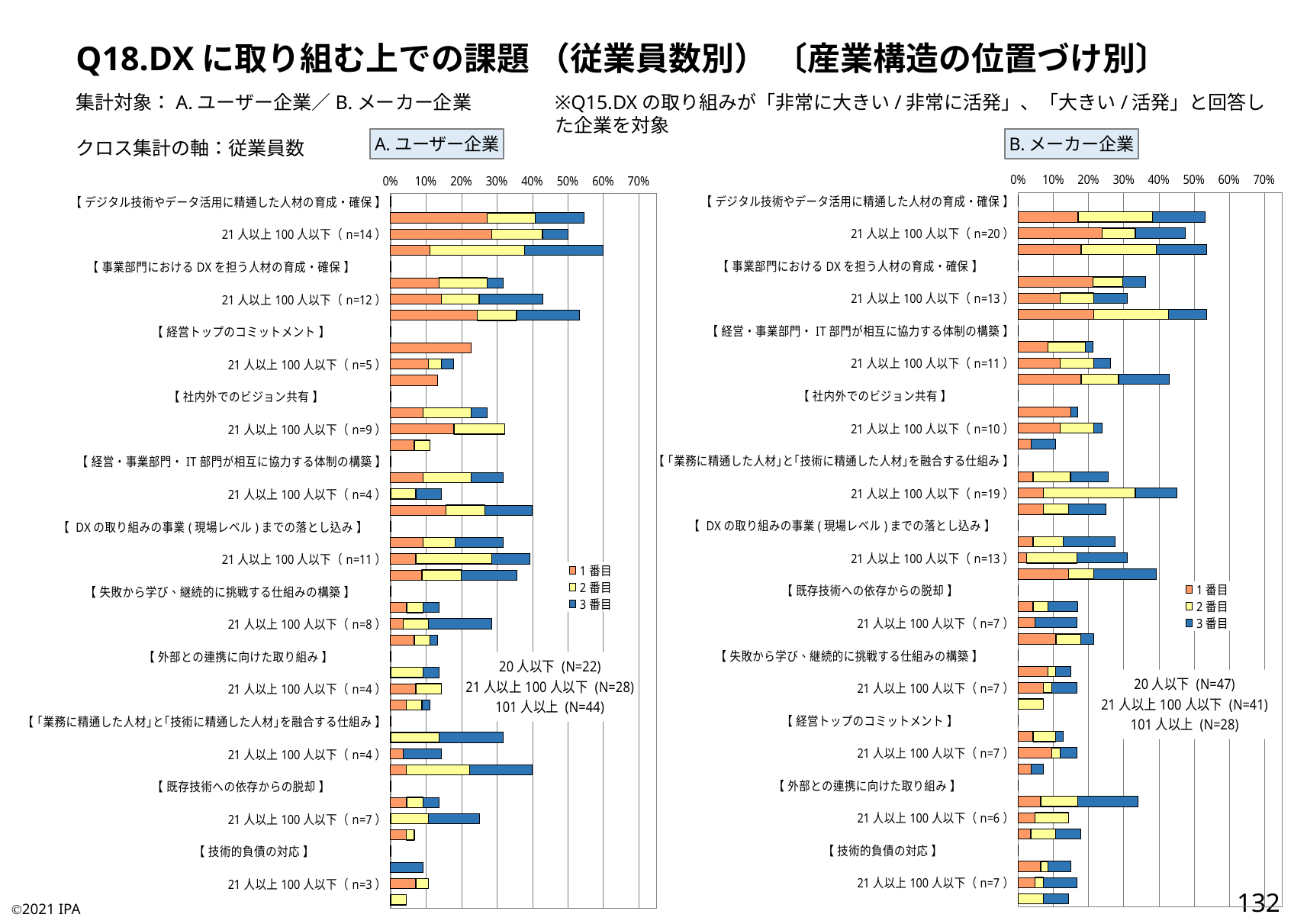
What kind of chart is the A. ユーザー企業 chart on the left? stacked bar chart In the A. ユーザー企業 chart, under 【経営トップのコミットメント】, which total bar is longer: 20人以下 or 101人以上? 20人以下 In the B. メーカー企業 chart, is the total bar for 20人以下 under 【デジタル技術やデータ活用に精通した人材の育成・確保】 greater or less than 50%? greater In the A. ユーザー企業 chart, is the total bar for 101人以上 under 【デジタル技術やデータ活用に精通した人材の育成・確保】 greater or less than 50%? greater In the B. メーカー企業 chart, is the total bar for 101人以上 under 【経営トップのコミットメント】 greater or less than 10%? less How many series does the legend of the B. メーカー企業 chart list? 3 How many challenge categories (bracketed headings) are shown in the A. ユーザー企業 chart? 11 What are the legend entries of the A. ユーザー企業 chart? 1番目, 2番目, 3番目 In the A. ユーザー企業 chart, which bar is the longest overall? 101人以上 under 【デジタル技術やデータ活用に精通した人材の育成・確保】 In the B. メーカー企業 chart, what is the sample size shown for 21人以上100人以下 under 【デジタル技術やデータ活用に精通した人材の育成・確保】? n=20